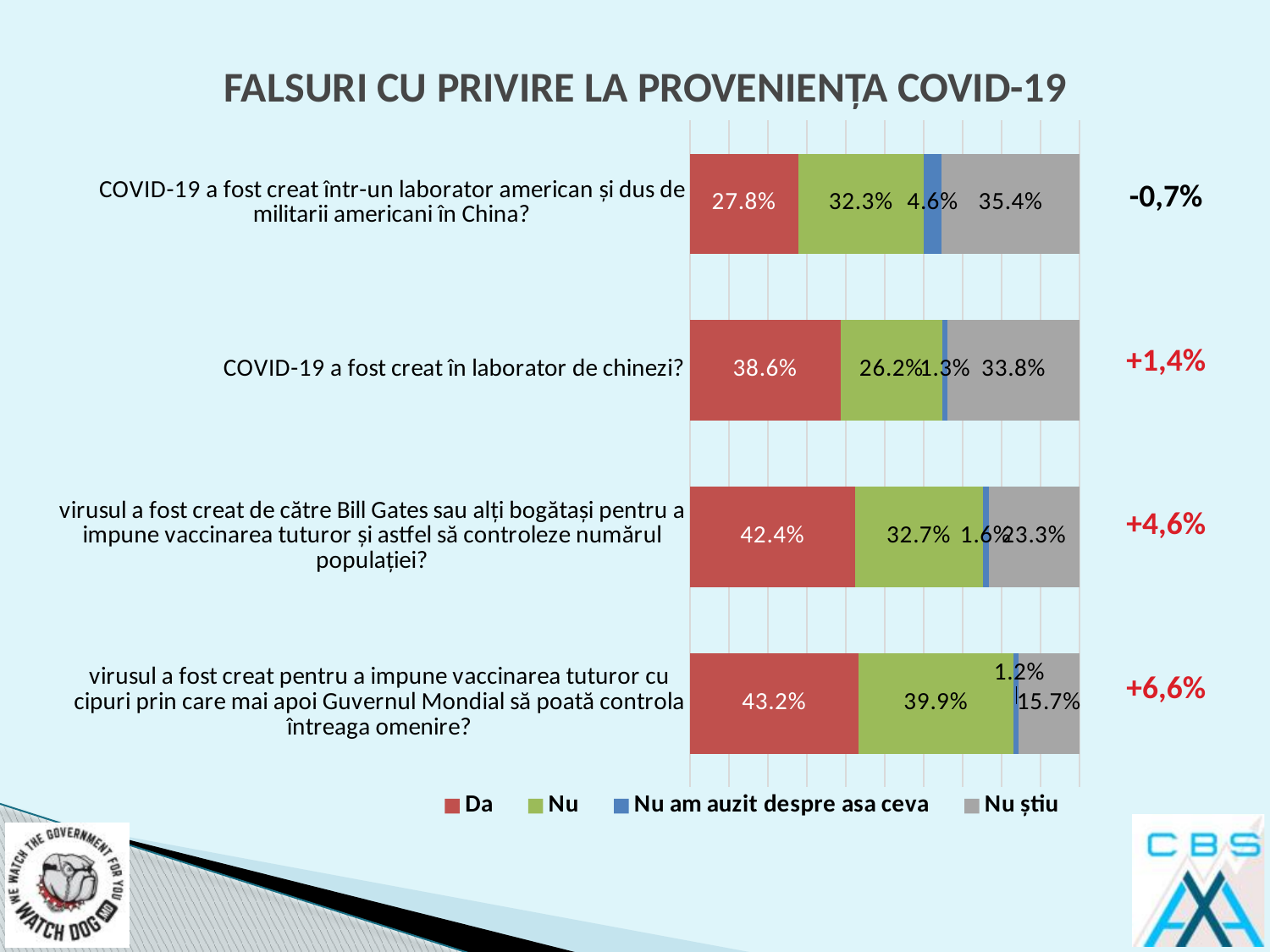
How many percentage points higher is the "Da" share for the Chinese laboratory statement than for the American laboratory statement? 10.8 percentage points What is the "Nu" value for the statement that the virus was created to impose vaccination with chips so that a World Government can control humanity? 39.9% What type of chart is shown on the slide? stacked bar chart What is the "Nu știu" value for the statement that COVID-19 was created in an American laboratory and brought to China by American soldiers? 35.4% Which statement has the highest "Da" percentage? virusul a fost creat pentru a impune vaccinarea tuturor cu cipuri prin care mai apoi Guvernul Mondial să poată controla întreaga omenire? How many statements (categories) are shown in the chart? 4 Which has a larger "Nu" share: the Bill Gates statement or the chips/World Government statement? the chips/World Government statement What percentage answered "Nu am auzit despre asa ceva" for the statement about the virus being created by Bill Gates or other rich people to impose vaccination? 1.6% How many series does the legend list? 4 What percentage answered "Da" to the statement that COVID-19 was created in a Chinese laboratory ("COVID-19 a fost creat în laborator de chinezi?")? 38.6% Which statement has the lowest "Nu știu" percentage? virusul a fost creat pentru a impune vaccinarea tuturor cu cipuri prin care mai apoi Guvernul Mondial să poată controla întreaga omenire? What is the title of the chart on the slide? FALSURI CU PRIVIRE LA PROVENIENȚA COVID-19